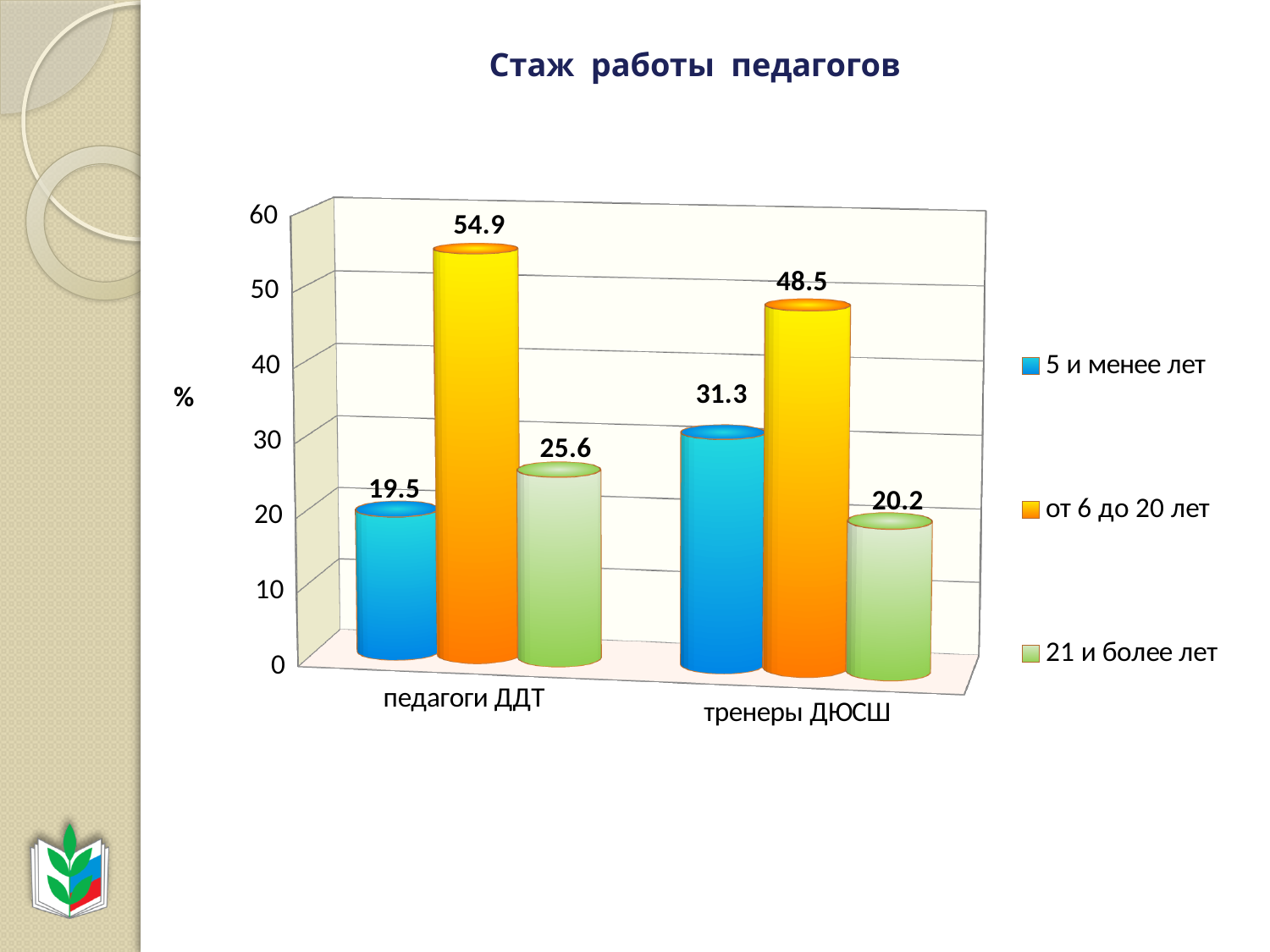
Is the value for "21 и более лет" in the "тренеры ДЮСШ" category greater or less than 30? less Which series has the highest value in the "тренеры ДЮСШ" category? от 6 до 20 лет What kind of chart is shown on the slide? bar chart What is the title of the chart? Стаж работы педагогов What is the value for "21 и более лет" in the "педагоги ДДТ" category? 25.6 What is the value for "от 6 до 20 лет" in the "педагоги ДДТ" category? 54.9 Which is larger: the "5 и менее лет" value for "педагоги ДДТ" or for "тренеры ДЮСШ"? тренеры ДЮСШ What is the difference between the "от 6 до 20 лет" values for "педагоги ДДТ" and "тренеры ДЮСШ"? 6.4 Which series has the lowest value in the "педагоги ДДТ" category? 5 и менее лет How many categories are shown on the x axis? 2 What is the value for "5 и менее лет" in the "тренеры ДЮСШ" category? 31.3 How many series does the legend list? 3